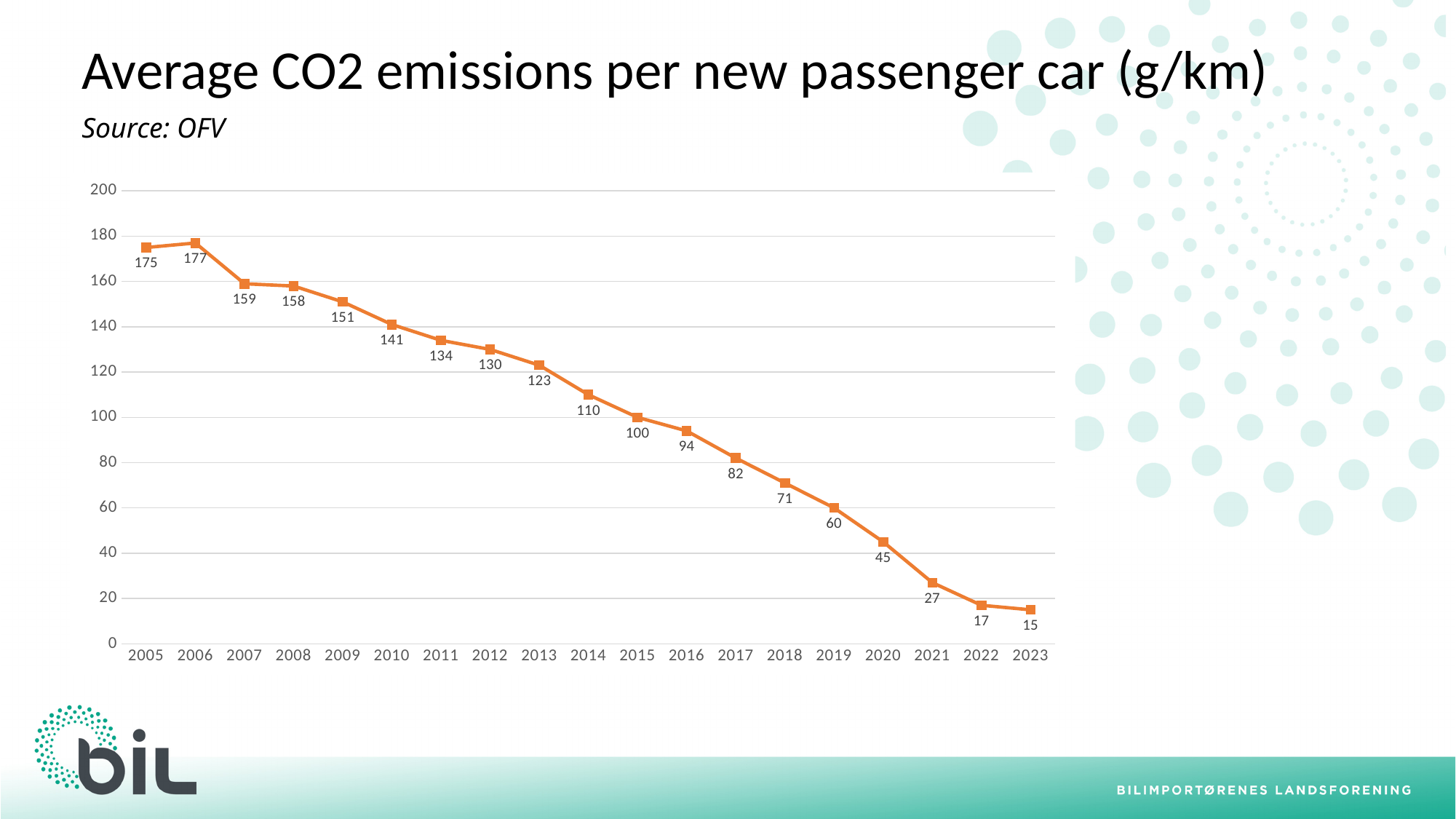
Is the value for 2019 greater or less than 80? less Which year has the lowest average CO2 emissions per new passenger car? 2023 By how much did the value fall from 2015 to 2016? 6 What source is cited for the chart data? OFV How many years are plotted on the chart? 19 Do the values generally rise or fall from 2006 to 2023? Fall Which year has the larger value, 2013 or 2017? 2013 What is the difference between the values for 2005 and 2023? 160 What was the average CO2 emission per new passenger car in 2010? 141 What value is shown for 2020? 45 What kind of chart is shown on the slide? Line chart Which year has the highest average CO2 emissions per new passenger car? 2006